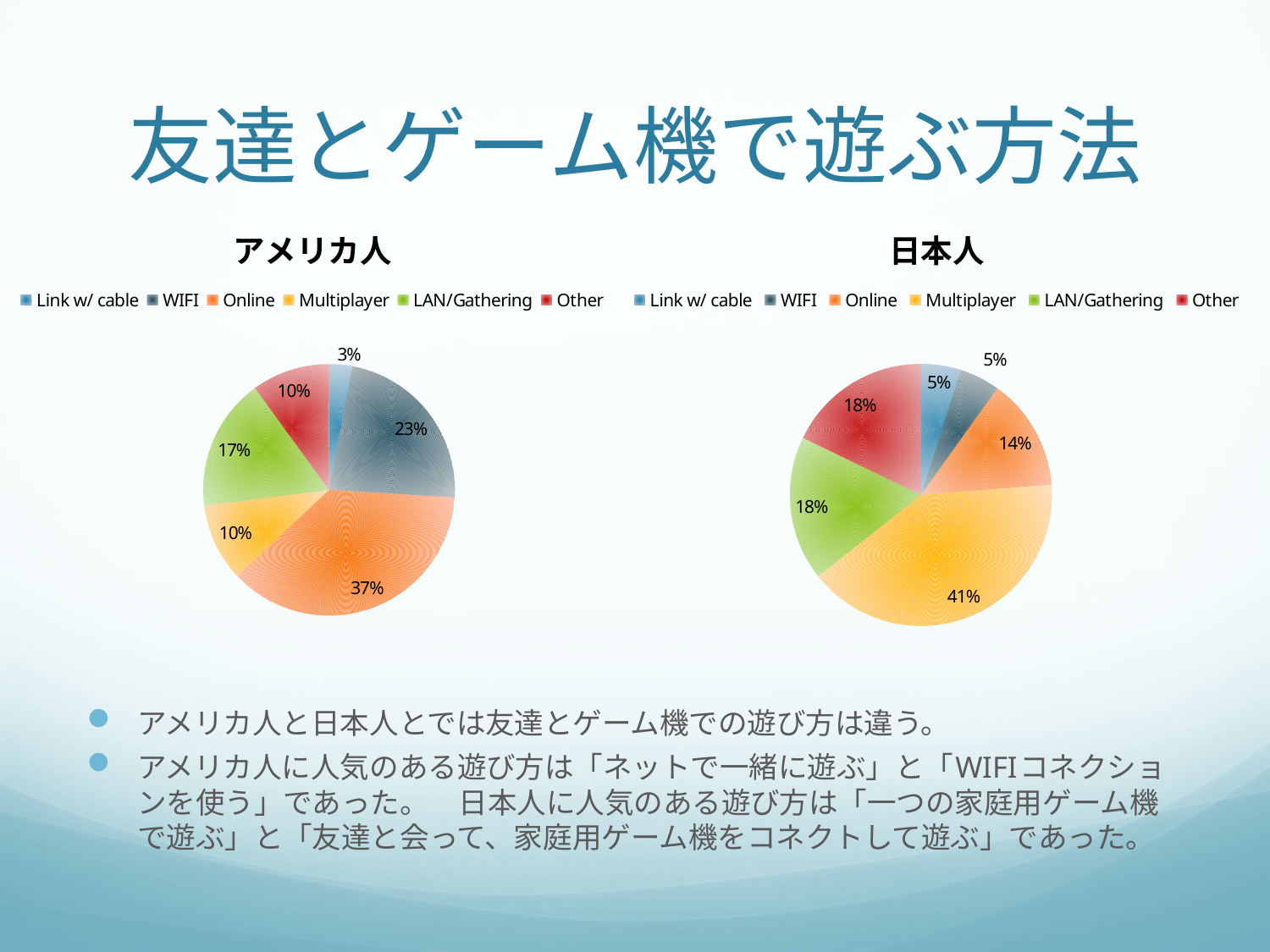
Which is larger in the 日本人 pie chart: LAN/Gathering or Online? LAN/Gathering In the アメリカ人 pie chart, what percentage is shown for WIFI? 23% In the 日本人 pie chart, which category has the largest share? Multiplayer In the 日本人 pie chart, what percentage is shown for Online? 14% In the アメリカ人 pie chart, what is the combined share of Multiplayer and Other? 20% How many categories does the legend of the アメリカ人 pie chart list? 6 In the アメリカ人 pie chart, what percentage is shown for Online? 37% What type of chart is used for the 日本人 data? Pie chart What is the difference between the Online share in the アメリカ人 pie chart and the Online share in the 日本人 pie chart? 23% In the 日本人 pie chart, what percentage is shown for Multiplayer? 41% In the アメリカ人 pie chart, which category has the smallest share? Link w/ cable In the アメリカ人 pie chart, which category has the largest share? Online